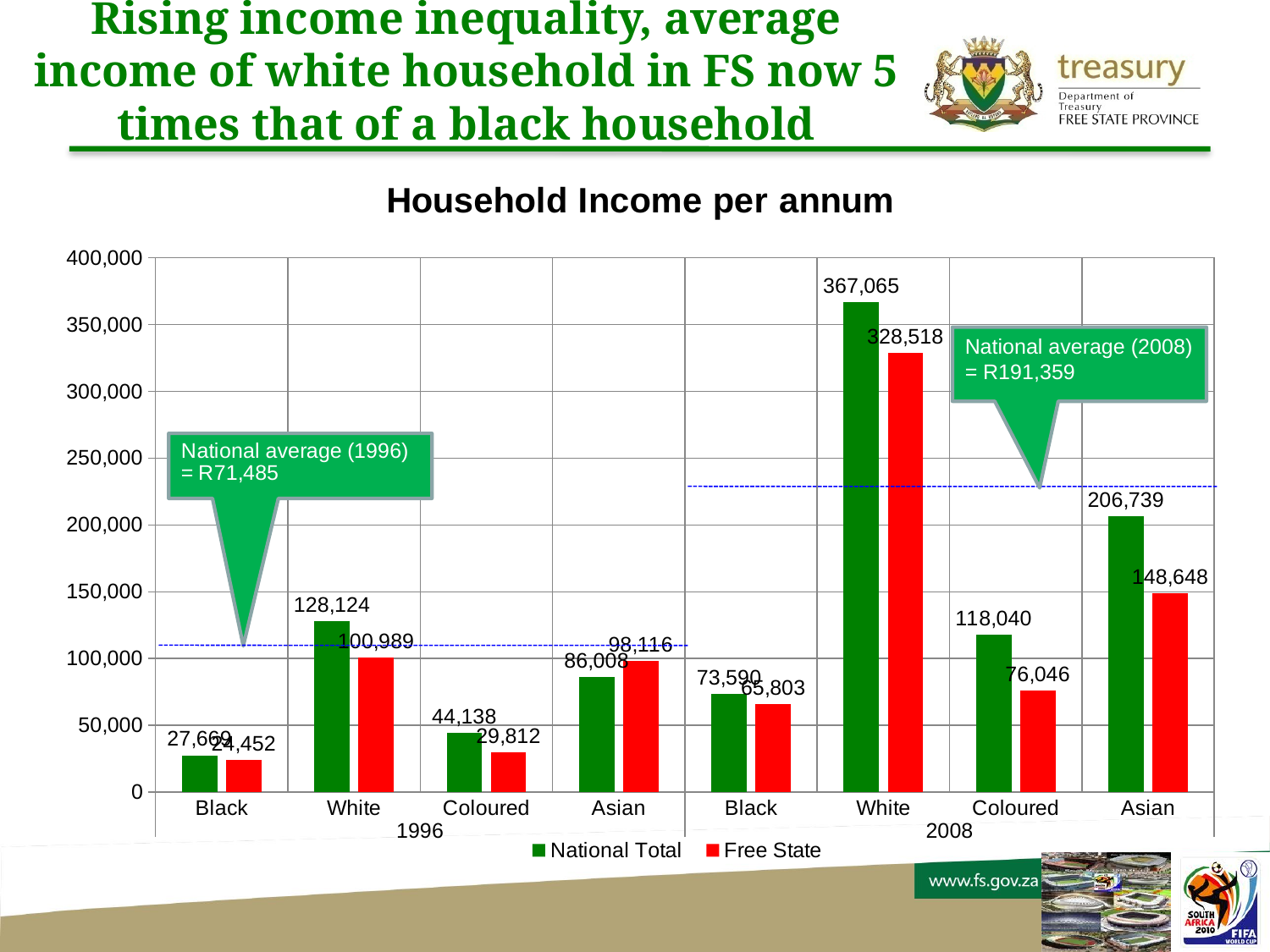
What is the Free State household income for Black households in 2008? 65,803 For Asian households in 1996, which is larger: the National Total or the Free State value? Free State What kind of chart is shown on the slide? Bar chart Is the National Total household income for Asian households in 2008 greater or less than 200,000? greater Which category has the highest National Total household income on the chart? White (2008) Which category has the lowest Free State household income on the chart? Black (1996) What is the National Total household income for White households in 2008? 367,065 What is the difference between the National Total and Free State household income for White households in 2008? 38,547 What is the Free State household income for Asian households in 2008? 148,648 According to the callout on the chart, what was the national average household income in 2008? R191,359 What is the National Total household income for Coloured households in 1996? 44,138 How many series does the legend list? 2